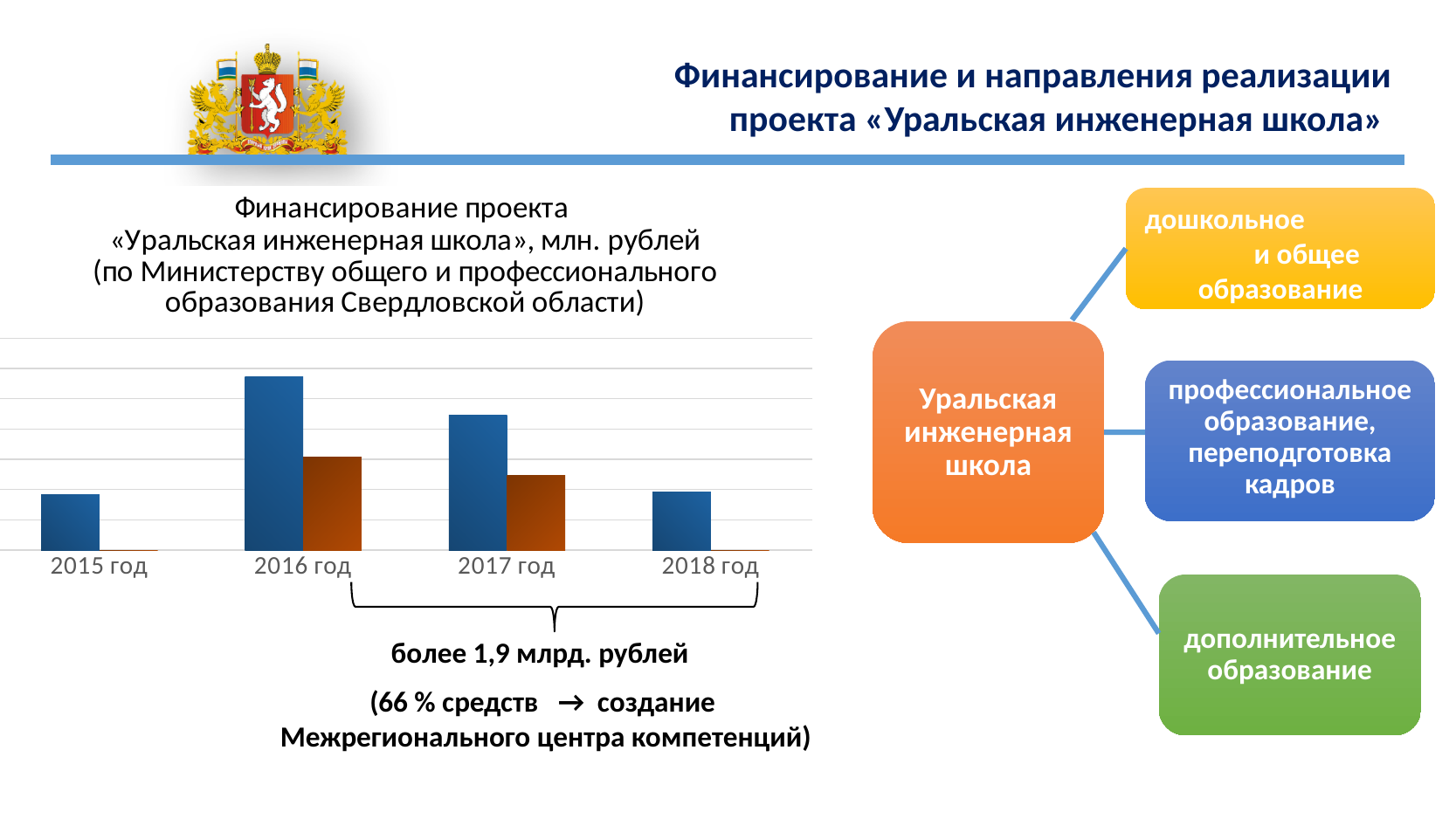
Is the orange bar for 2017 год taller or shorter than the orange bar for 2016 год? shorter What kind of chart is shown on the left of the slide? bar chart What is the first year shown on the x axis of the chart? 2015 год How many bar colours (series) are plotted for each year in the chart? 2 Which year has the tallest orange bar in the chart? 2016 год Do the blue bars rise steadily from 2015 год to 2018 год? No, they rise in 2016 and then fall Which year has the tallest blue bar in the chart? 2016 год Is the blue bar for 2015 год taller or shorter than the blue bar for 2017 год? shorter In what units does the chart title say the financing is measured? млн. рублей Is the blue bar for 2016 год taller or shorter than the blue bar for 2017 год? taller How many year categories are shown on the x axis of the chart? 4